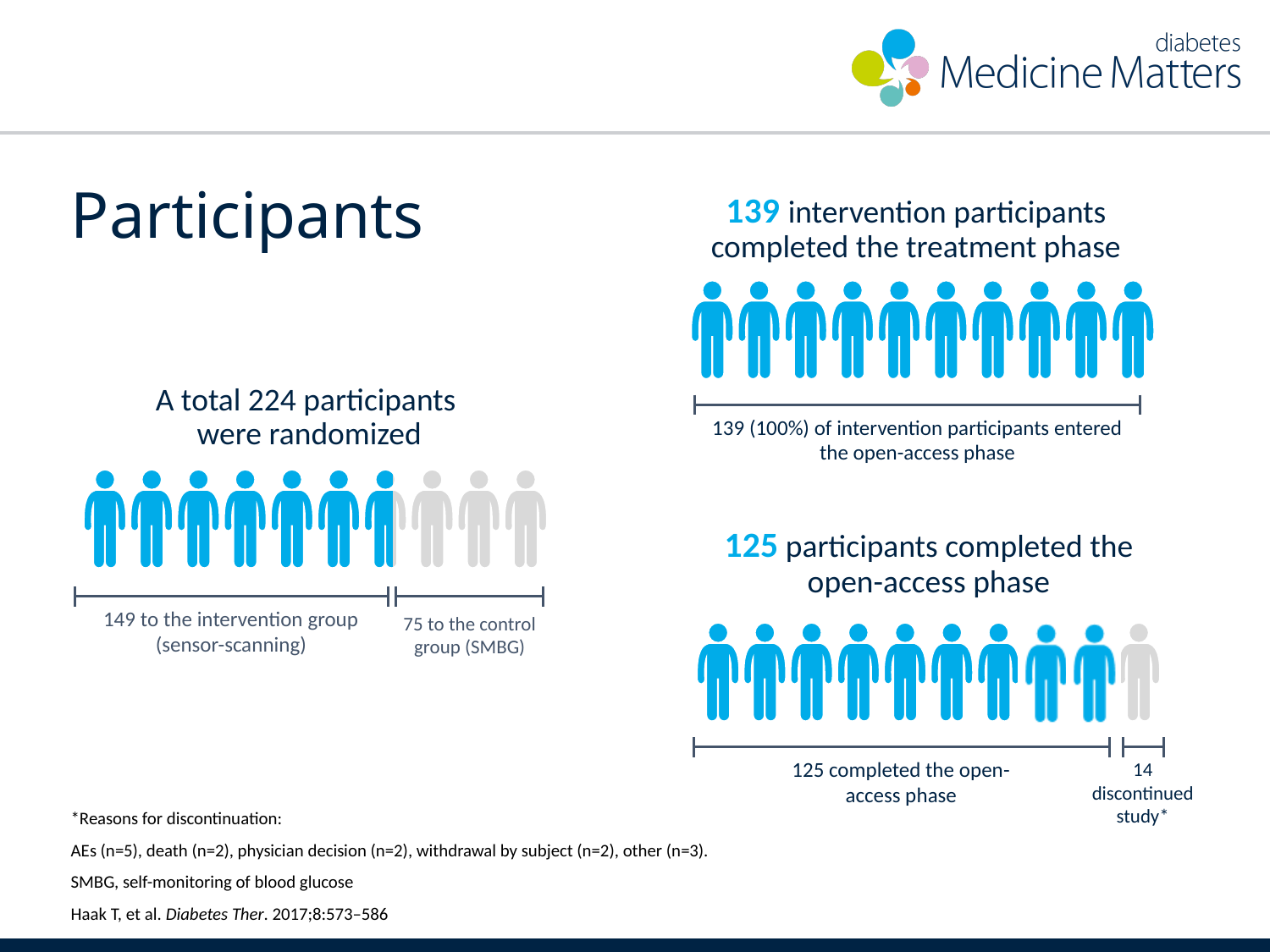
In the top-right pictograph, how many intervention participants completed the treatment phase? 139 In the left pictograph, how many person icons are shown in total? 10 In the left pictograph, what is the difference between the number of participants in the intervention group and the control group? 74 In the top-right pictograph, what percentage of intervention participants entered the open-access phase? 100% In the left pictograph, how many participants were randomized to the intervention group (sensor-scanning)? 149 In the left pictograph, which group received more participants, the intervention group or the control group? intervention group In the bottom-right pictograph, how many participants completed the open-access phase? 125 In the left pictograph, what colour are the icons representing the control group (SMBG)? grey In the left pictograph, what is the total number of participants randomized? 224 What kind of chart is used on this slide to show the participant numbers? pictograph In the bottom-right pictograph, how many participants discontinued the study? 14 In the left pictograph, how many participants were randomized to the control group (SMBG)? 75